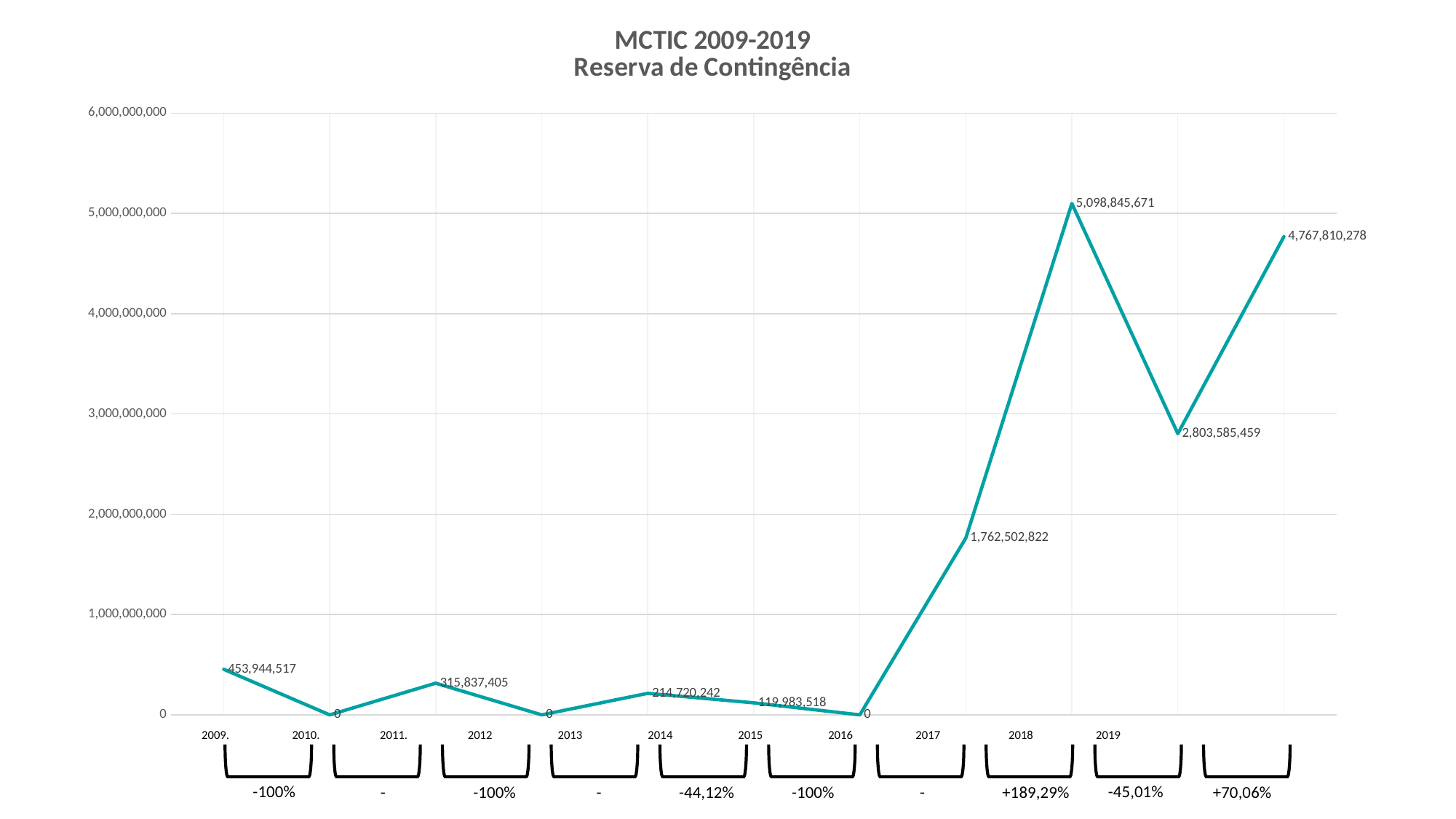
What type of chart is shown on the slide? line chart What is the value for 2019? 4,767,810,278 What is the value for 2017? 1,762,502,822 How many years (data points) are plotted on the chart? 11 What is the lowest value plotted on the chart? 0 Is the value for 2016 greater or less than 2,000,000,000? less What is the value for 2009? 453,944,517 What is the title of the chart? MCTIC 2009-2019 Reserva de Contingência Which is larger, the value for 2018 or the value for 2019? 2018 What is the difference between the values for 2017 and 2019? 3,005,307,456 Which year has the highest value? 2018 What percentage change is shown between 2017 and 2018 below the x axis? +189,29%